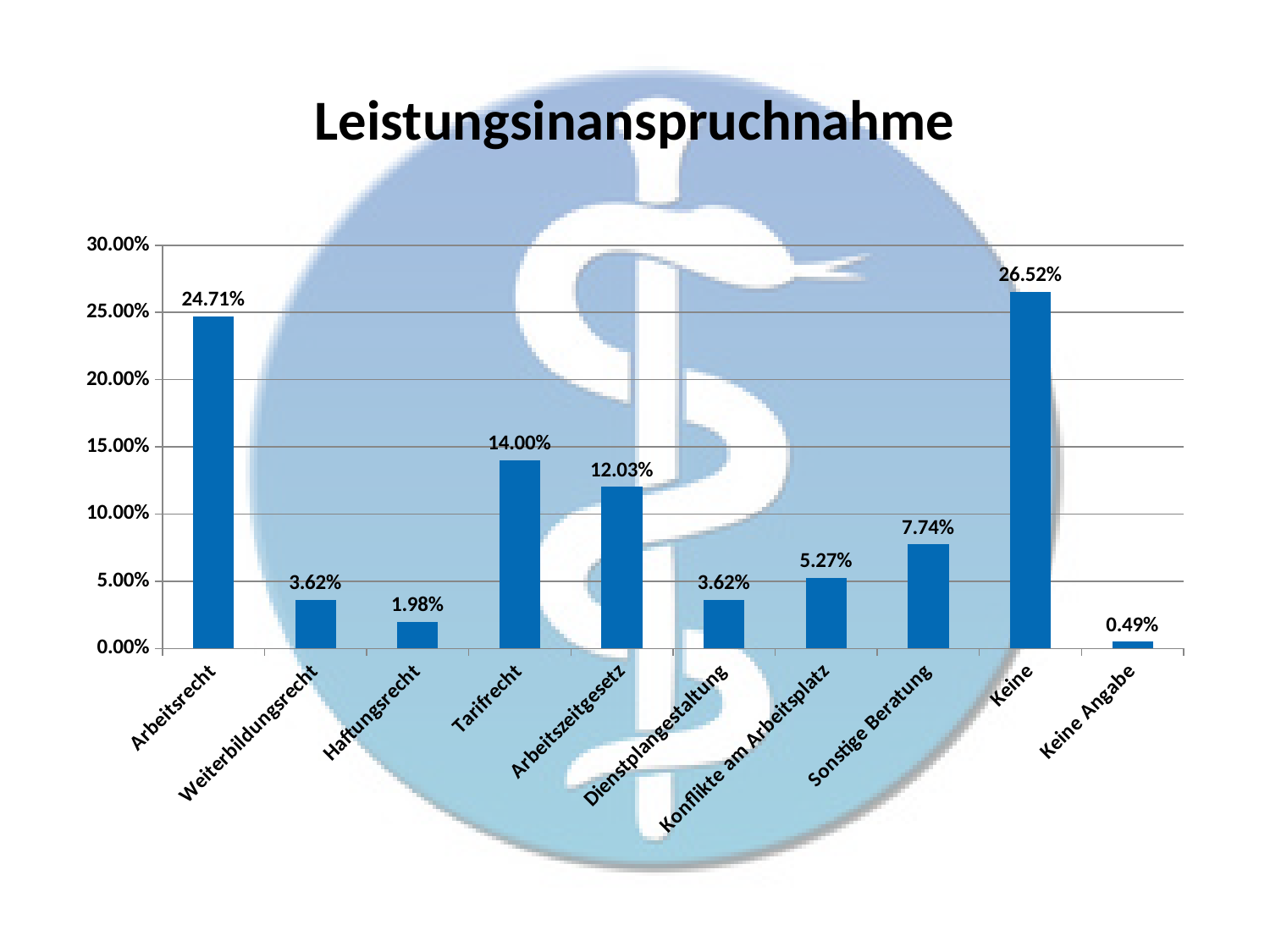
What is the difference between the values for Tarifrecht and Arbeitszeitgesetz? 1.97% What is the value for Tarifrecht? 14.00% What is the difference between the values for Keine and Arbeitsrecht? 1.81% Is the value for Arbeitszeitgesetz greater or less than 10.00%? greater Which category has the lowest value? Keine Angabe What is the title of the chart? Leistungsinanspruchnahme What is the value for Arbeitsrecht? 24.71% Which category has the highest value? Keine What kind of chart is shown on the slide? Bar chart What is the value for Sonstige Beratung? 7.74% How many categories are shown on the x axis? 10 Which is larger, the value for Konflikte am Arbeitsplatz or the value for Haftungsrecht? Konflikte am Arbeitsplatz